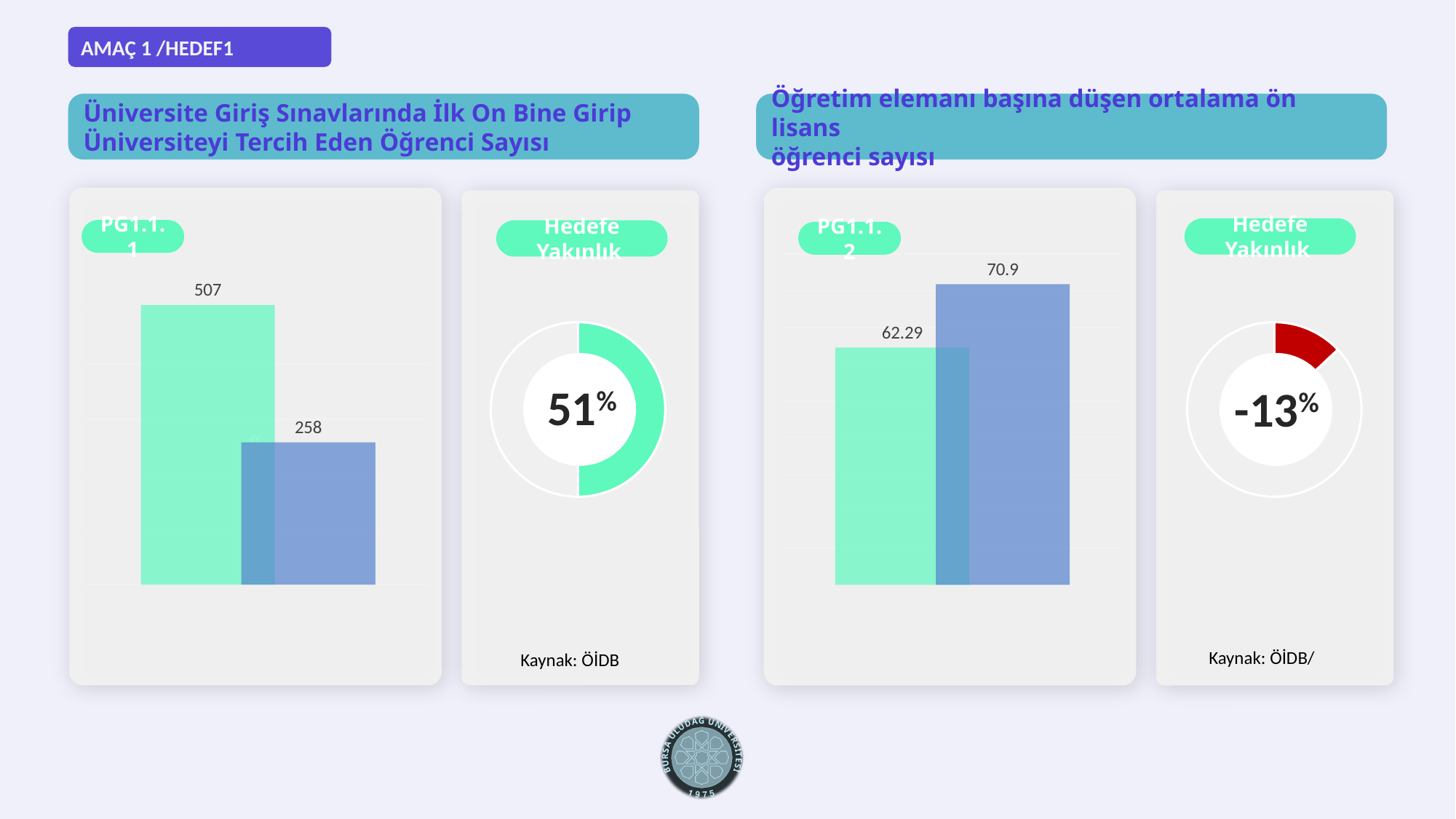
In the PG1.1.1 bar chart on the left, which bar is taller, the green one or the blue one? the green one In the PG1.1.1 bar chart on the left, what value is labelled on the green bar? 507 In the PG1.1.1 bar chart on the left, what value is labelled on the blue bar? 258 In the PG1.1.1 bar chart on the left, what is the difference between the green bar and the blue bar? 249 In the PG1.1.2 bar chart on the right, what is the difference between the blue bar and the green bar? 8.61 In the PG1.1.2 bar chart on the right, what value is labelled on the blue bar? 70.9 What percentage is shown in the Hedefe Yakınlık donut chart next to the PG1.1.2 chart? -13% How many bars are plotted in the PG1.1.1 chart on the left? 2 In the PG1.1.2 bar chart on the right, which bar is taller, the green one or the blue one? the blue one What kind of chart is the PG1.1.2 chart on the right side of the slide? bar chart What percentage is shown in the Hedefe Yakınlık donut chart next to the PG1.1.1 chart? 51% In the PG1.1.2 bar chart on the right, what value is labelled on the green bar? 62.29